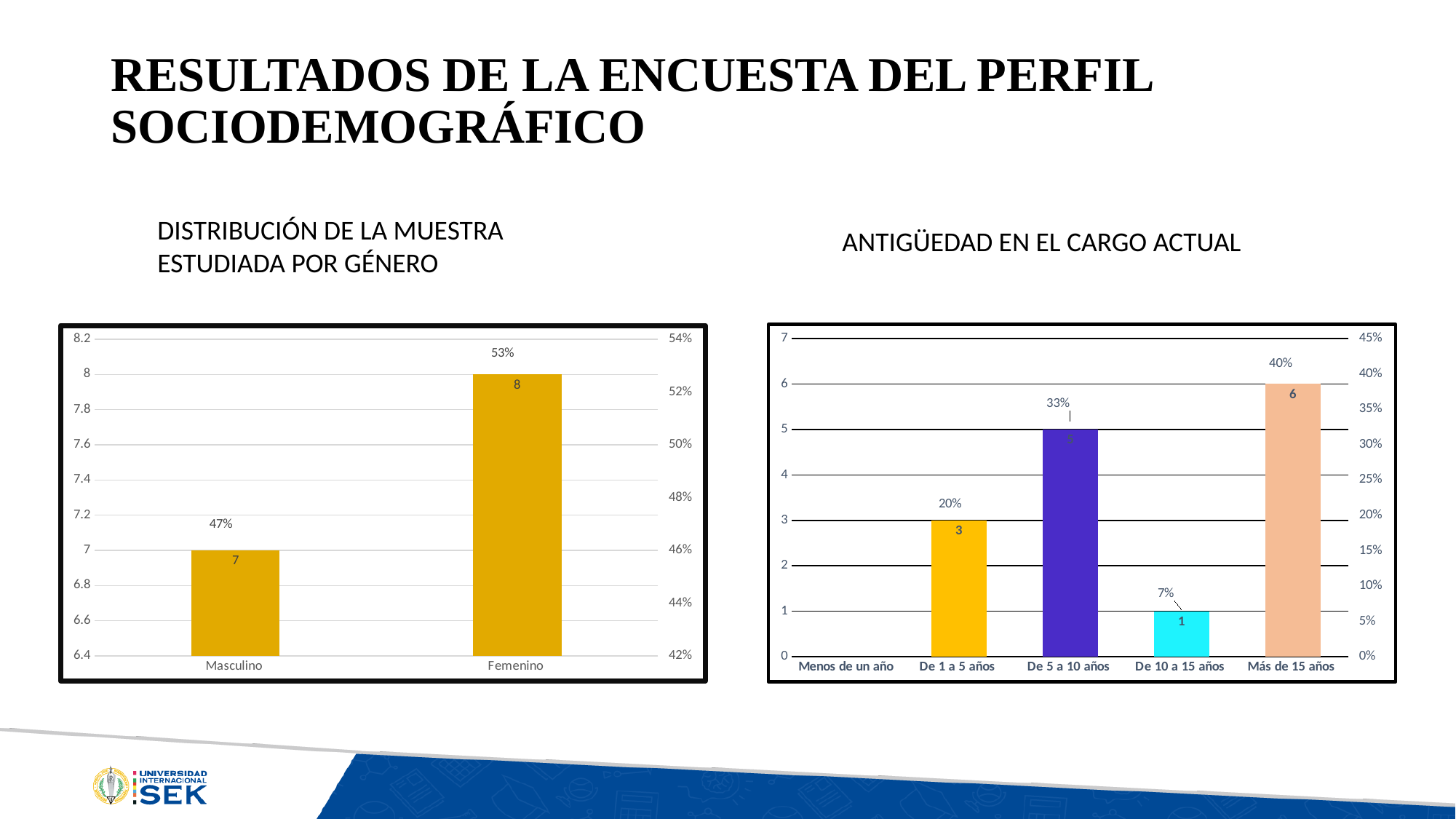
In the chart titled 'ANTIGÜEDAD EN EL CARGO ACTUAL', what is the difference between the counts for 'Más de 15 años' and 'De 1 a 5 años'? 3 What kind of chart is the one titled 'DISTRIBUCIÓN DE LA MUESTRA ESTUDIADA POR GÉNERO'? Bar chart In the chart titled 'DISTRIBUCIÓN DE LA MUESTRA ESTUDIADA POR GÉNERO', what is the difference between the Femenino and Masculino counts? 1 In the chart titled 'DISTRIBUCIÓN DE LA MUESTRA ESTUDIADA POR GÉNERO', which category has the higher count? Femenino In the chart titled 'ANTIGÜEDAD EN EL CARGO ACTUAL', how many categories are listed on the x axis? 5 In the chart titled 'ANTIGÜEDAD EN EL CARGO ACTUAL', which is larger: the count for 'De 1 a 5 años' or 'De 10 a 15 años'? De 1 a 5 años In the chart titled 'ANTIGÜEDAD EN EL CARGO ACTUAL', what is the count for 'De 5 a 10 años'? 5 In the chart titled 'DISTRIBUCIÓN DE LA MUESTRA ESTUDIADA POR GÉNERO', what percentage is shown for Femenino? 53% In the chart titled 'ANTIGÜEDAD EN EL CARGO ACTUAL', which category with a visible bar has the lowest count? De 10 a 15 años In the chart titled 'ANTIGÜEDAD EN EL CARGO ACTUAL', what percentage is shown for 'Más de 15 años'? 40% In the chart titled 'DISTRIBUCIÓN DE LA MUESTRA ESTUDIADA POR GÉNERO', what is the count for Masculino? 7 In the chart titled 'ANTIGÜEDAD EN EL CARGO ACTUAL', which category has the highest count? Más de 15 años